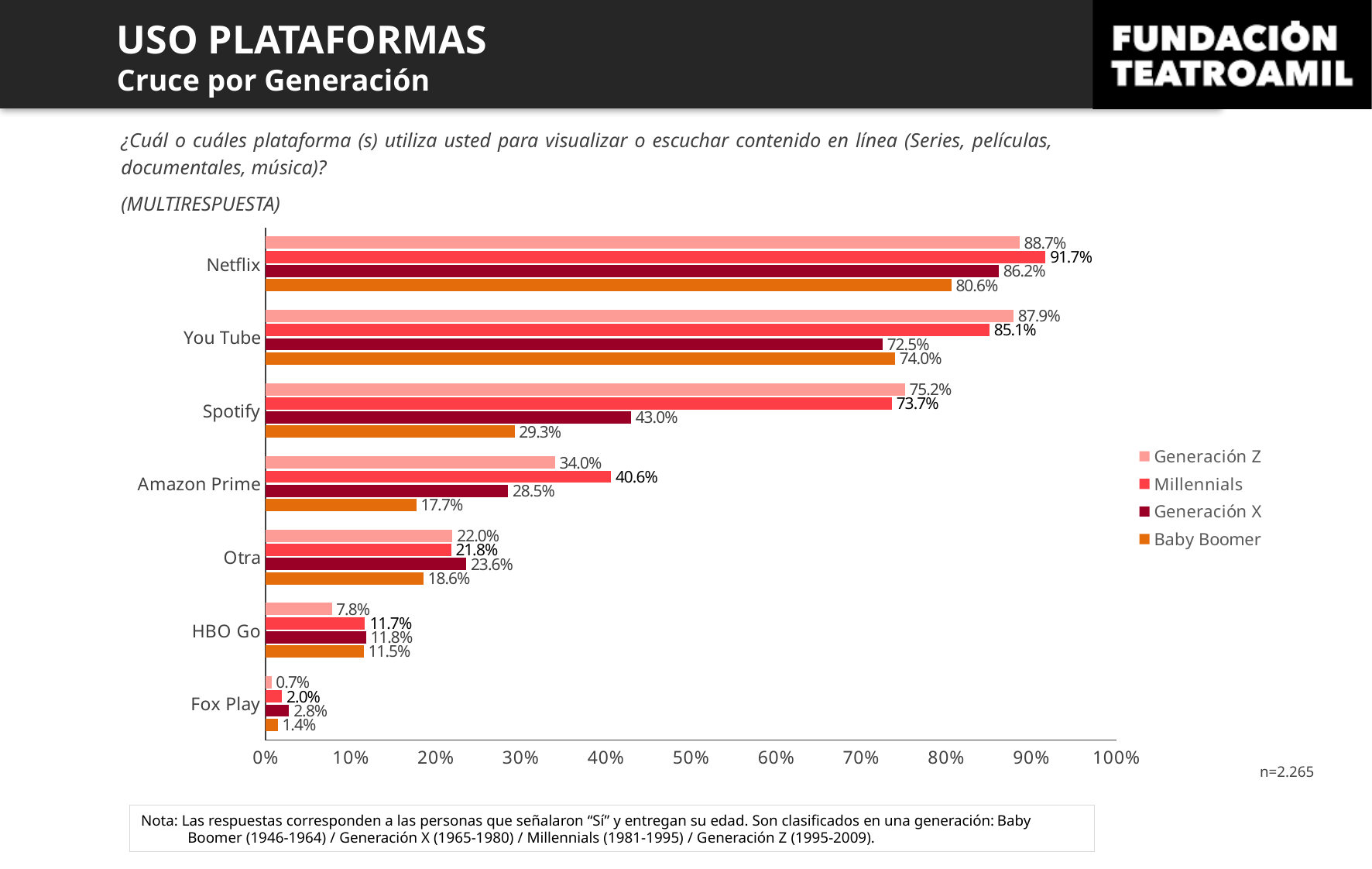
What is the value for Generación Z for HBO Go? 7.8% Which platform has the lowest value for Generación Z? Fox Play How many platforms are listed on the chart? 7 What is the difference between the Generación Z and Baby Boomer values for Spotify? 45.9% What kind of chart is shown on the slide? Bar chart What is the value for Generación X for Amazon Prime? 28.5% For Amazon Prime, which is larger: the Millennials value or the Generación Z value? Millennials How many series does the legend list? 4 What is the value for Baby Boomer for Spotify? 29.3% Is the Generación X value for You Tube greater or less than 70%? greater What is the value for Millennials for Netflix? 91.7% Which platform has the highest value for Baby Boomer? Netflix